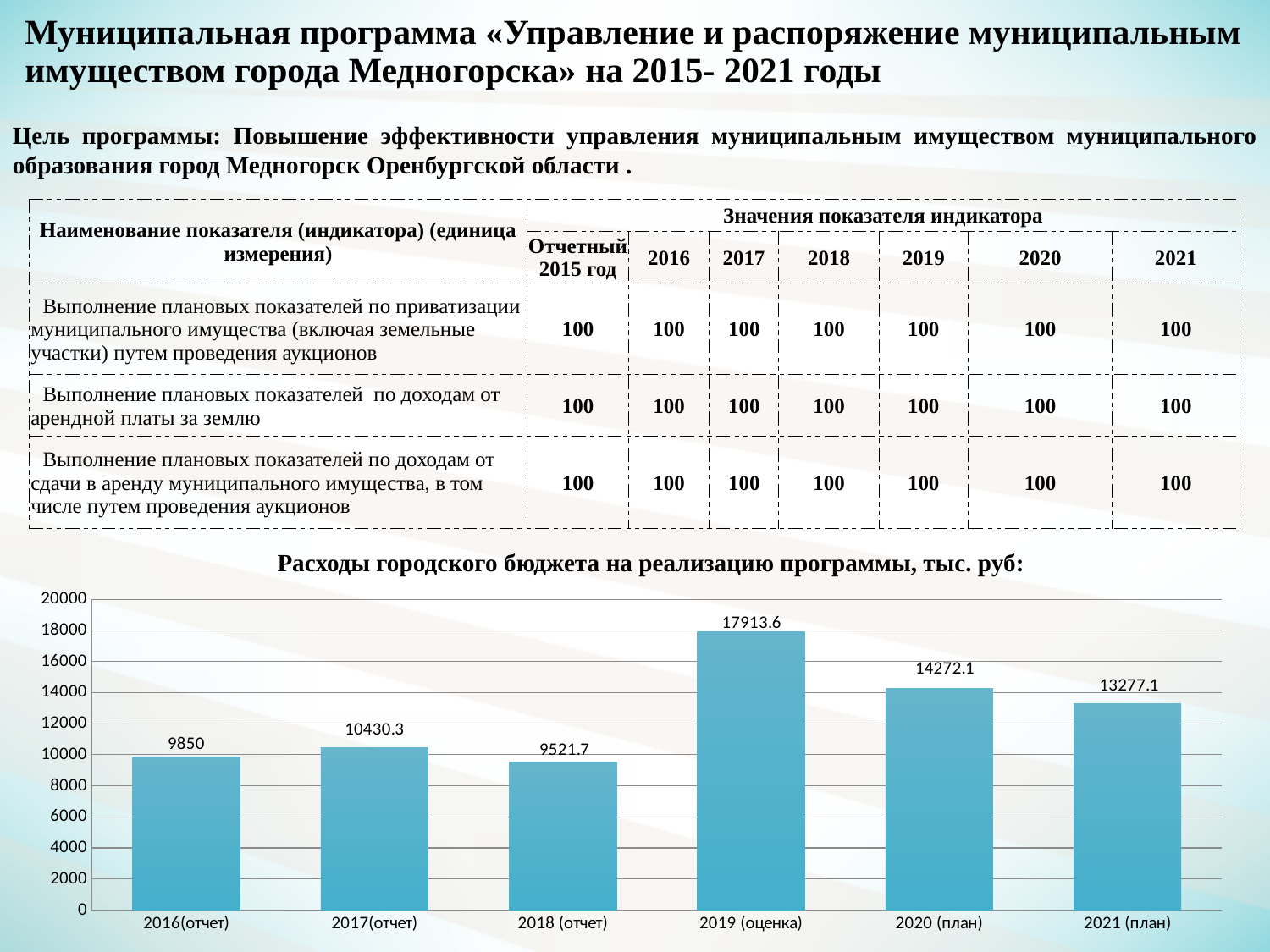
What is the title of the chart? Расходы городского бюджета на реализацию программы, тыс. руб: How many categories are shown on the x axis of the chart? 6 Which category has the lowest value in the chart? 2018 (отчет) What is the value for 2016(отчет) in the chart? 9850 Which category has the highest value in the chart? 2019 (оценка) What is the value for 2019 (оценка) in the chart? 17913.6 Which is larger, the value for 2020 (план) or the value for 2021 (план)? 2020 (план) What is the difference between the values for 2020 (план) and 2021 (план)? 995 Is the value for 2019 (оценка) greater or less than 16000? greater What is the value for 2021 (план) in the chart? 13277.1 What is the difference between the values for 2017(отчет) and 2016(отчет)? 580.3 What kind of chart is shown on the slide? bar chart